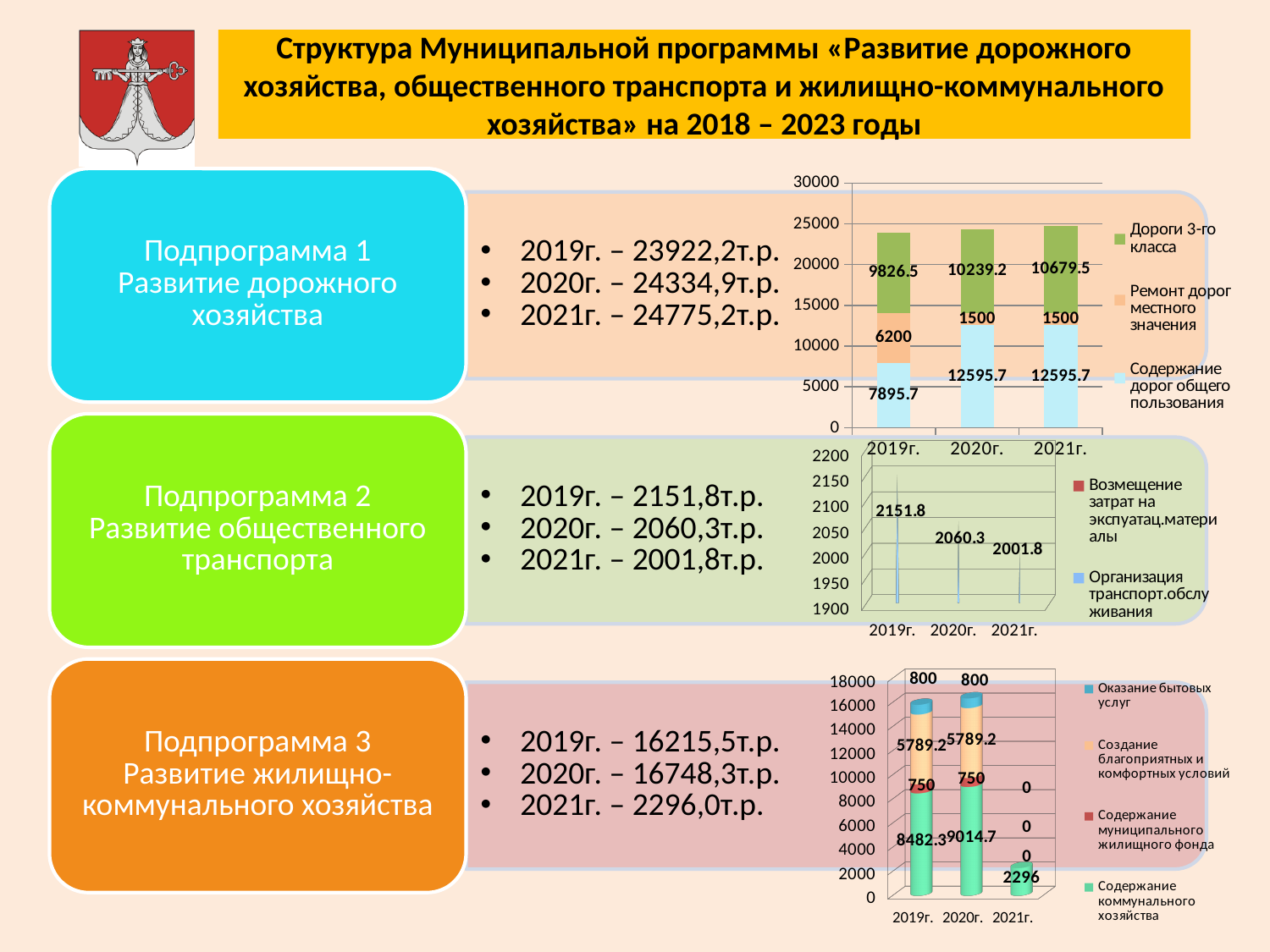
In the bottom chart, which year has the lowest value for Содержание коммунального хозяйства? 2021г. In the top chart, which year has the highest value for Дороги 3-го класса? 2021г. In the top chart, what is the difference between the Дороги 3-го класса values for 2020г. and 2019г.? 412.7 In the middle chart, do the values rise or fall from 2019г. to 2021г.? fall In the top chart, what is the value for Ремонт дорог местного значения in 2019г.? 6200 In the bottom chart, how many series does the legend list? 4 In the middle chart, what is the value shown for 2020г.? 2060.3 In the bottom chart, what is the value for Содержание коммунального хозяйства in 2020г.? 9014.7 In the top chart, what is the value for Дороги 3-го класса in 2021г.? 10679.5 In the top chart, what is the value for Содержание дорог общего пользования in 2019г.? 7895.7 In the top chart, how many series does the legend list? 3 In the top chart, what is the total of the stacked bar for 2020г.? 24334.9